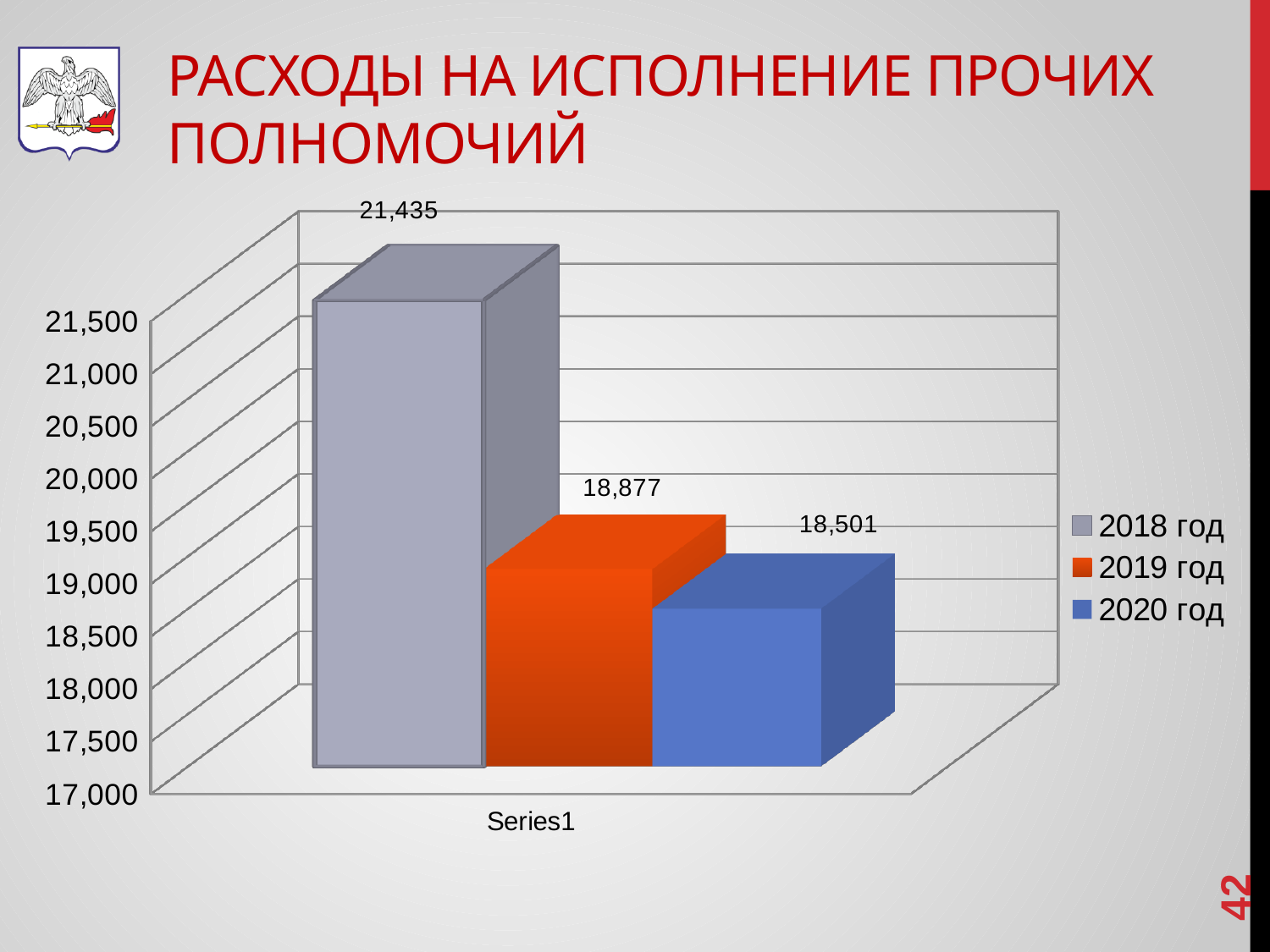
Is the value for 2018 год greater or less than 21,000? greater Which is larger, the value for 2019 год or the value for 2020 год? 2019 год Do the values rise or fall from 2018 год to 2020 год? fall Which year has the highest value? 2018 год Which year has the lowest value? 2020 год What is the difference between the values for 2018 год and 2019 год? 2,558 What kind of chart is shown on the slide? bar chart How many series does the legend list? 3 What is the value for 2019 год? 18,877 What is the difference between the values for 2019 год and 2020 год? 376 What is the value for 2020 год? 18,501 What is the value for 2018 год? 21,435